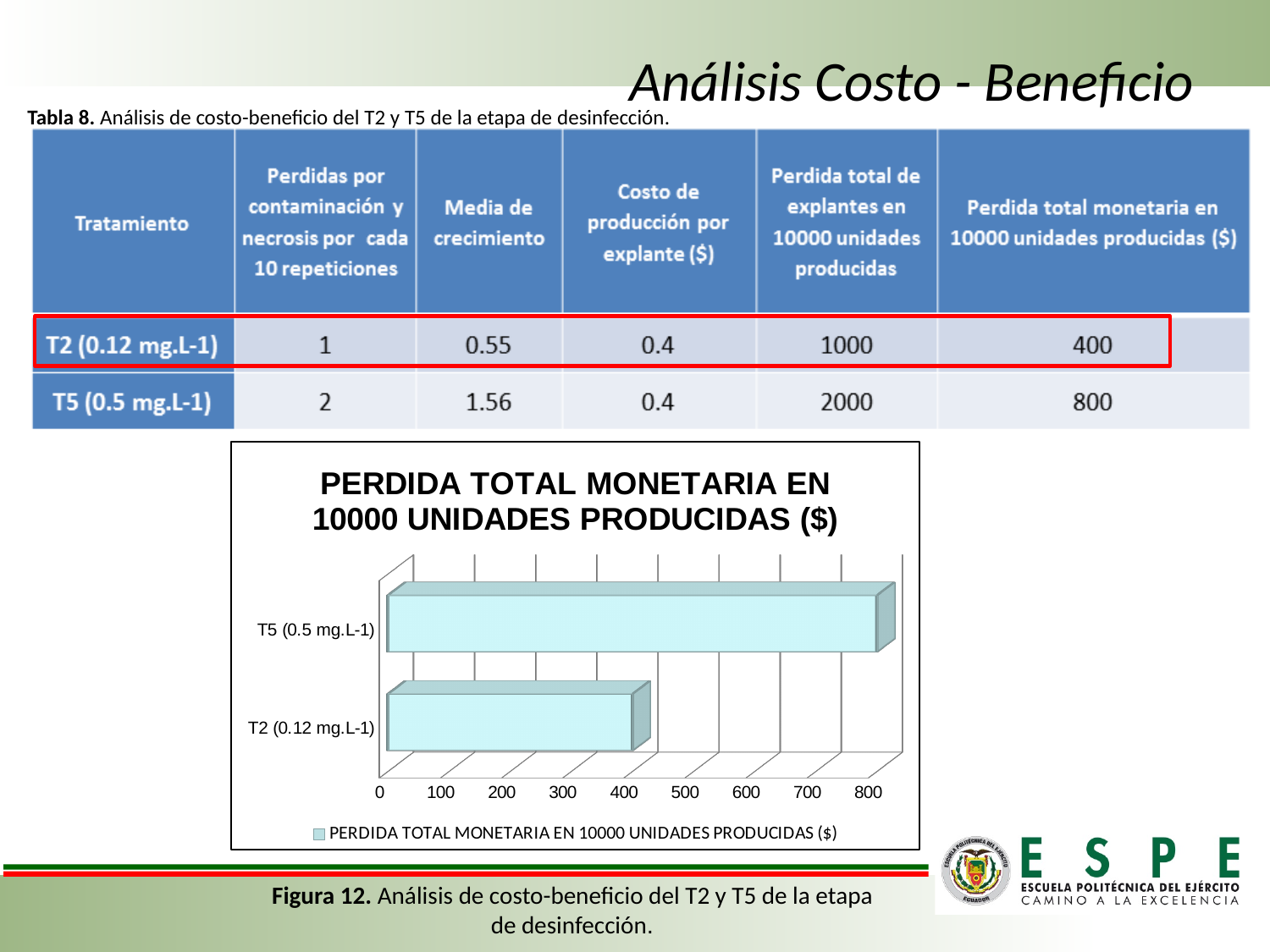
Is the value for T5 (0.5 mg.L-1) greater or less than 600? greater What is the value for T5 (0.5 mg.L-1) in the bar chart? 800 How many categories does the bar chart show? 2 Which is larger, the value for T2 (0.12 mg.L-1) or the value for T5 (0.5 mg.L-1)? T5 (0.5 mg.L-1) What is the difference between the values for T5 (0.5 mg.L-1) and T2 (0.12 mg.L-1)? 400 Which category has the highest value in the bar chart? T5 (0.5 mg.L-1) Is the value for T2 (0.12 mg.L-1) greater or less than 500? less What is the value for T2 (0.12 mg.L-1) in the bar chart? 400 What is the title of the bar chart? PERDIDA TOTAL MONETARIA EN 10000 UNIDADES PRODUCIDAS ($) How many series does the chart legend list? 1 What kind of chart is shown on the slide? bar chart Which category has the lowest value in the bar chart? T2 (0.12 mg.L-1)